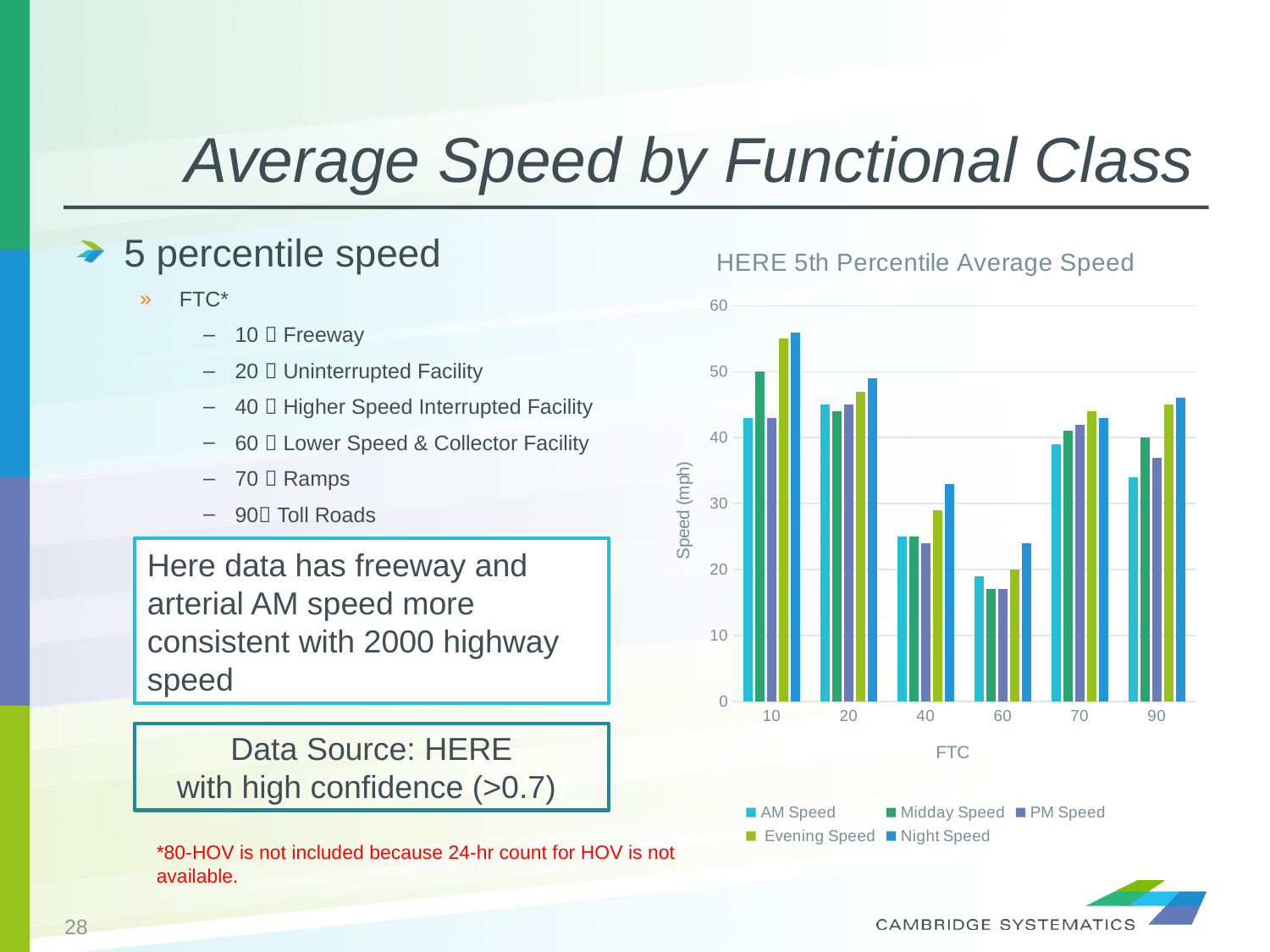
Is the Night Speed value for FTC 40 greater or less than 30? greater Which FTC category has the highest Night Speed? 10 Is the Midday Speed value for FTC 60 greater or less than 20? less How many FTC categories are shown on the x axis of the chart? 6 Which FTC category has the lowest AM Speed? 60 Is the Night Speed value for FTC 10 greater or less than 50? greater What kind of chart is the 'HERE 5th Percentile Average Speed' chart? bar chart For FTC 90, which is larger, the Night Speed or the AM Speed? Night Speed Which is larger, the AM Speed for FTC 10 or the AM Speed for FTC 60? FTC 10 What is the title of the chart's vertical axis? Speed (mph) How many series does the chart's legend list? 5